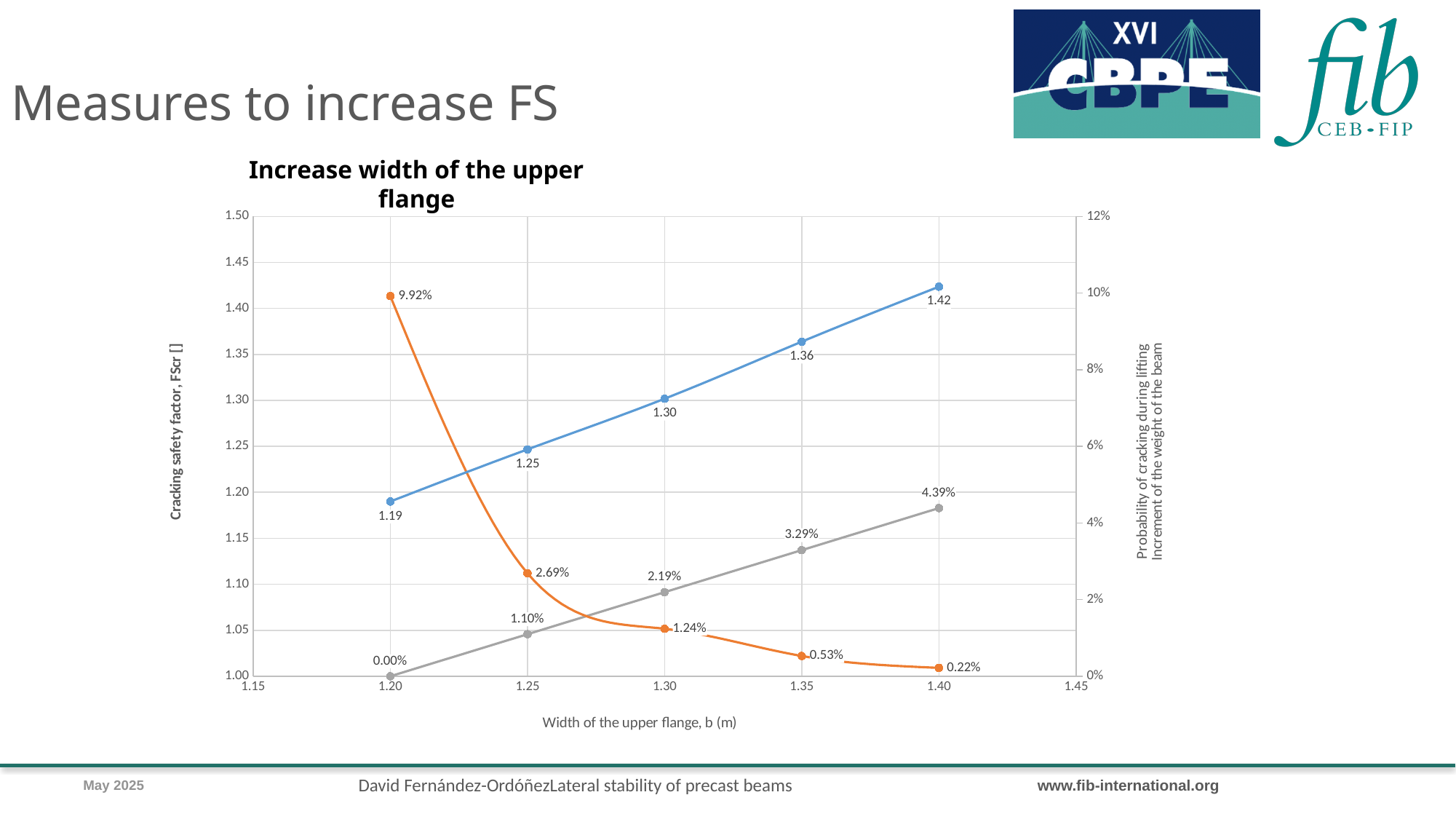
What is the value of the orange line at an upper flange width of 1.35 m? 0.53% What is the value of the orange line at an upper flange width of 1.20 m? 9.92% What is the title of the chart? Increase width of the upper flange What kind of chart is shown on the slide? line chart What is the difference between the grey line values at 1.40 m and 1.35 m? 1.10% What is the value of the grey line at an upper flange width of 1.40 m? 4.39% At which upper flange width is the cracking safety factor (blue line) highest? 1.40 At which upper flange width is the orange line lowest? 1.40 At an upper flange width of 1.25 m, which is larger: the orange line value or the grey line value? orange line Does the cracking safety factor (blue line) rise or fall as the width of the upper flange increases? rise What is the cracking safety factor (blue line) at an upper flange width of 1.30 m? 1.30 What is the difference between the cracking safety factor at 1.40 m and at 1.20 m (blue line)? 0.23